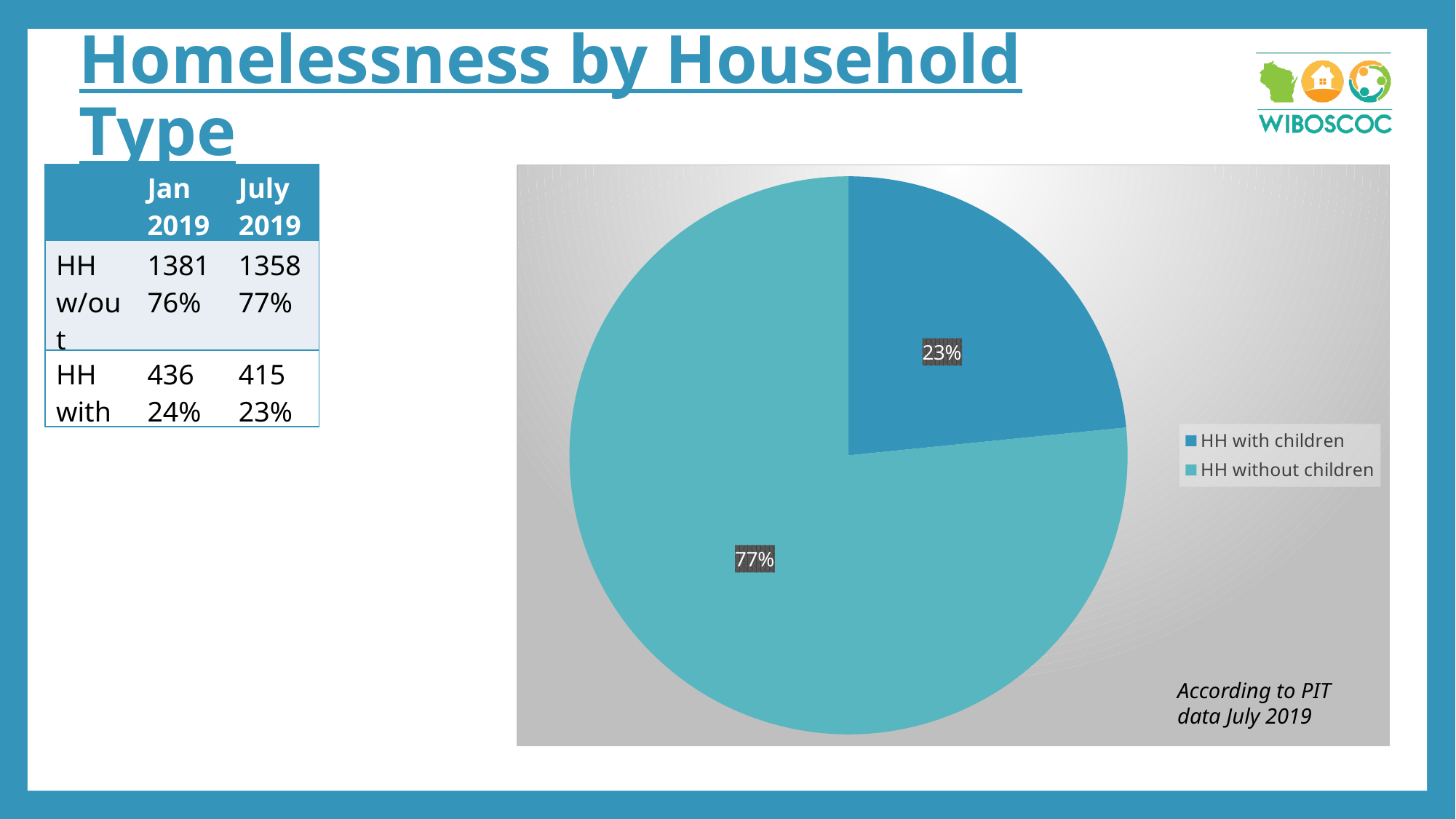
Which is larger in the pie chart, HH with children or HH without children? HH without children How many slices does the pie chart have? 2 According to the note on the chart, what data source is the pie chart based on? PIT data July 2019 What colour is the HH with children slice in the pie chart? dark blue What share of the pie is labelled for HH without children? 77% Which slice of the pie chart is the smallest? HH with children What is the difference in percentage points between the HH without children slice and the HH with children slice? 54 What kind of chart is shown on the slide? pie chart What share of the pie is labelled for HH with children? 23% Which slice of the pie chart is the largest? HH without children How many entries does the legend of the pie chart list? 2